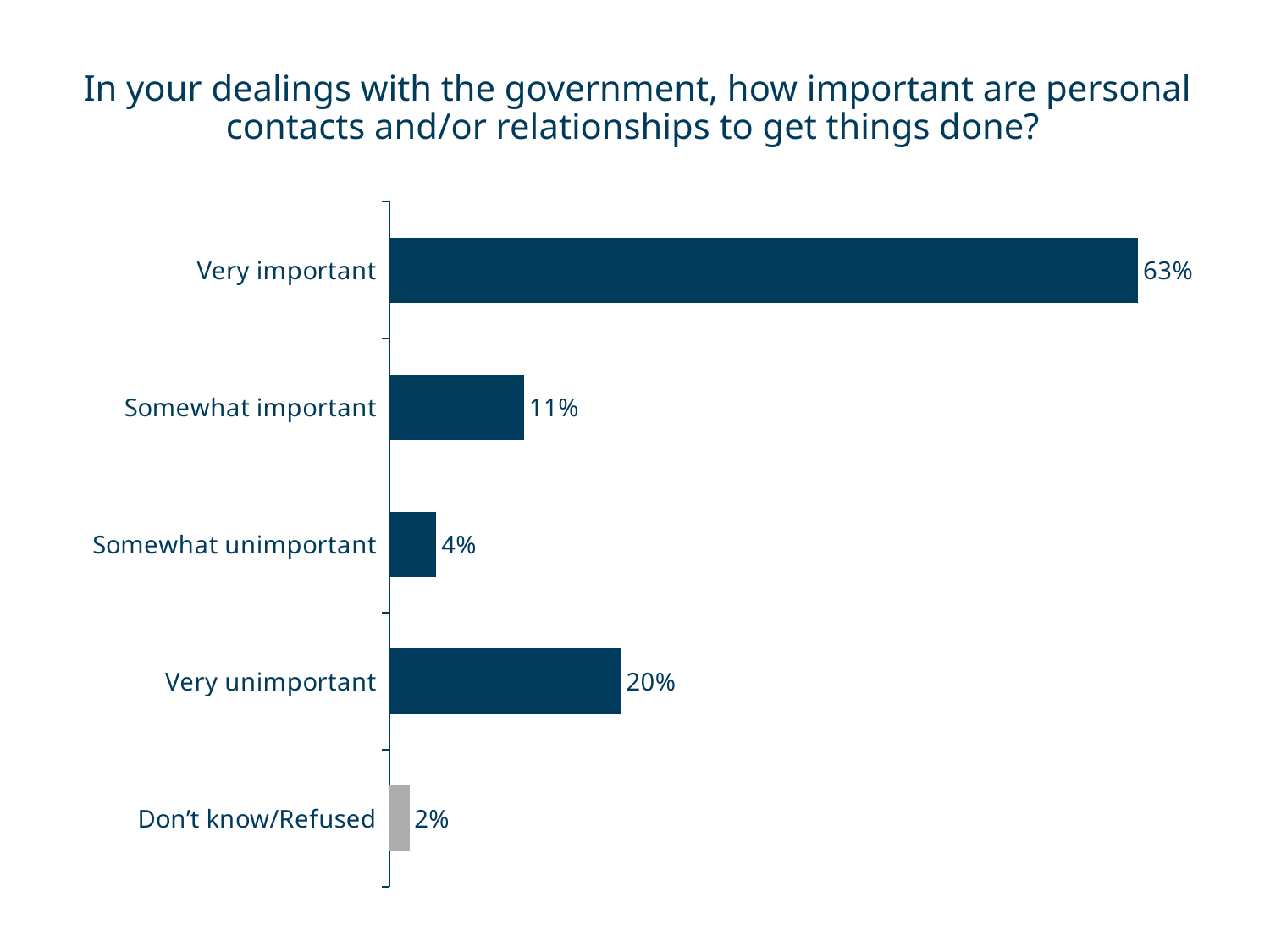
What is the value for Don't know/Refused? 2% How many response categories are shown in the chart? 5 Which bar is shown in a different colour (grey) from the others? Don't know/Refused Which is larger, the value for Somewhat important or the value for Very unimportant? Very unimportant Which response category has the lowest value? Don't know/Refused What is the value for Very unimportant? 20% What is the difference between the Very important and Very unimportant values? 43% Which response category has the highest value? Very important What is the value for Somewhat unimportant? 4% What percentage of respondents said personal contacts are somewhat important? 11% What kind of chart is shown on the slide? Bar chart What percentage of respondents said personal contacts are very important? 63%